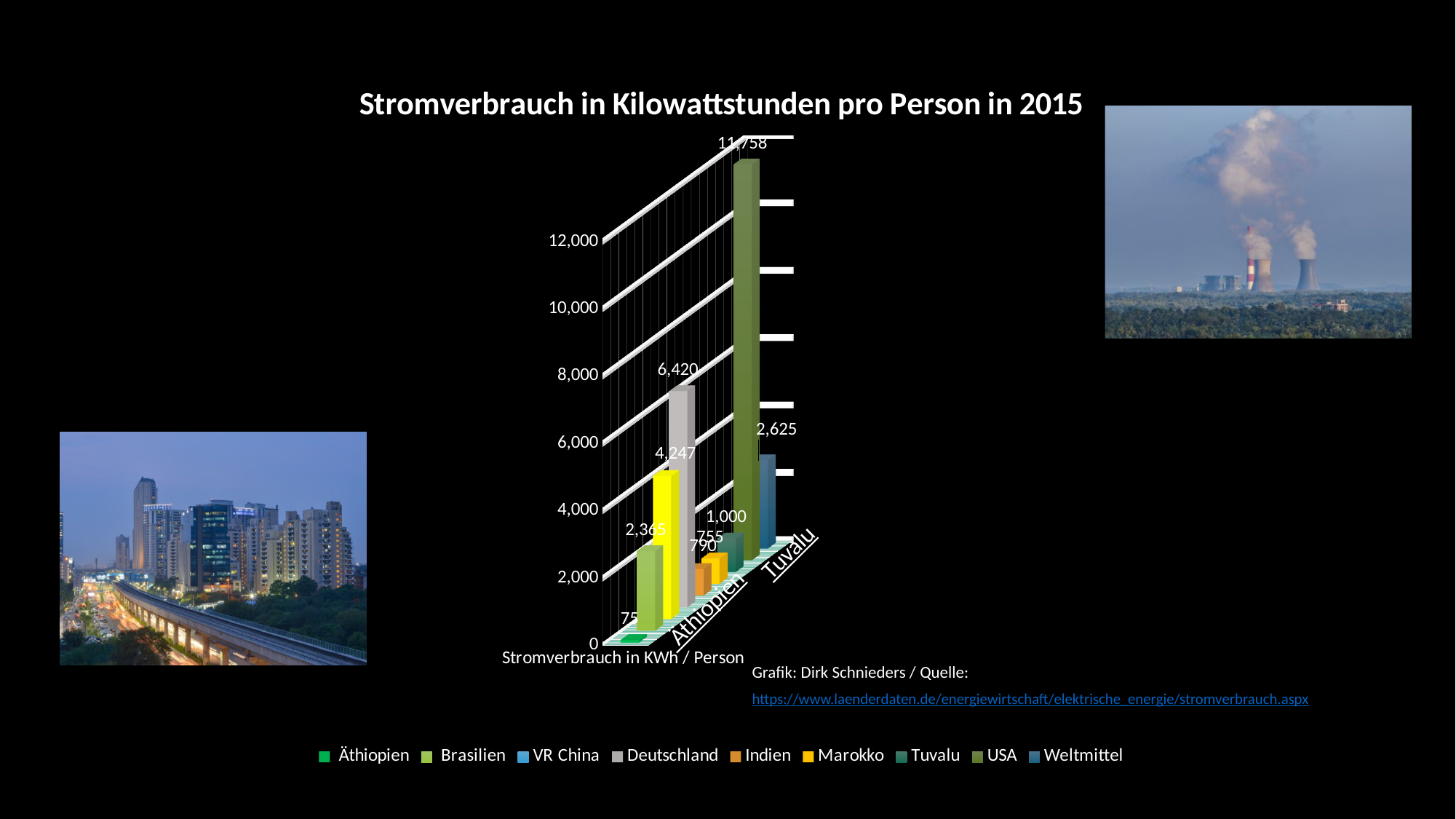
Which country has the lowest electricity consumption per person in the chart? Äthiopien Which country has the highest electricity consumption per person in the chart? USA How many series does the legend list? 9 Which is larger, the value for Deutschland or the value for Weltmittel? Deutschland What is the value shown for Brasilien? 2,365 What is the value shown for Deutschland? 6,420 What is the title of the chart? Stromverbrauch in Kilowattstunden pro Person in 2015 What kind of chart is shown on the slide? bar chart What is the value shown for Weltmittel? 2,625 What is the value shown for USA? 11,758 What is the difference between the values for USA and Deutschland? 5,338 What is the value shown for Tuvalu? 1,000